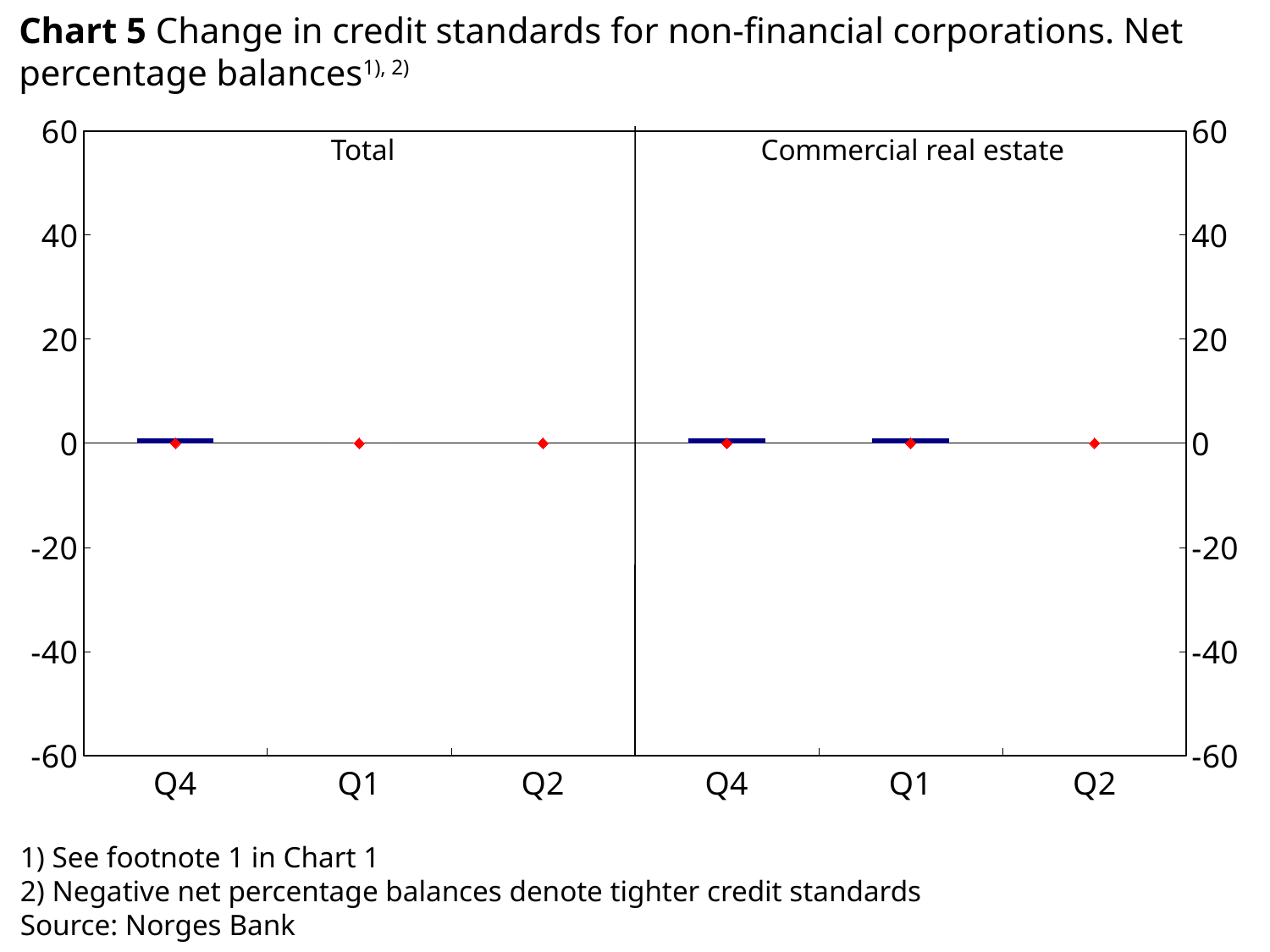
Is the value for Q2 in the Commercial real estate panel greater or less than -20? greater What is the highest value shown on the vertical axis? 60 What kind of chart is shown on the slide? bar chart How many quarters are plotted in the Total panel? 3 Is the value for Q1 in the Commercial real estate panel greater or less than 20? less Is the value for Q4 in the Total panel greater or less than 20? less What is the lowest value shown on the vertical axis? -60 What are the two panels of the chart labelled? Total and Commercial real estate How many quarters are plotted in the Commercial real estate panel? 3